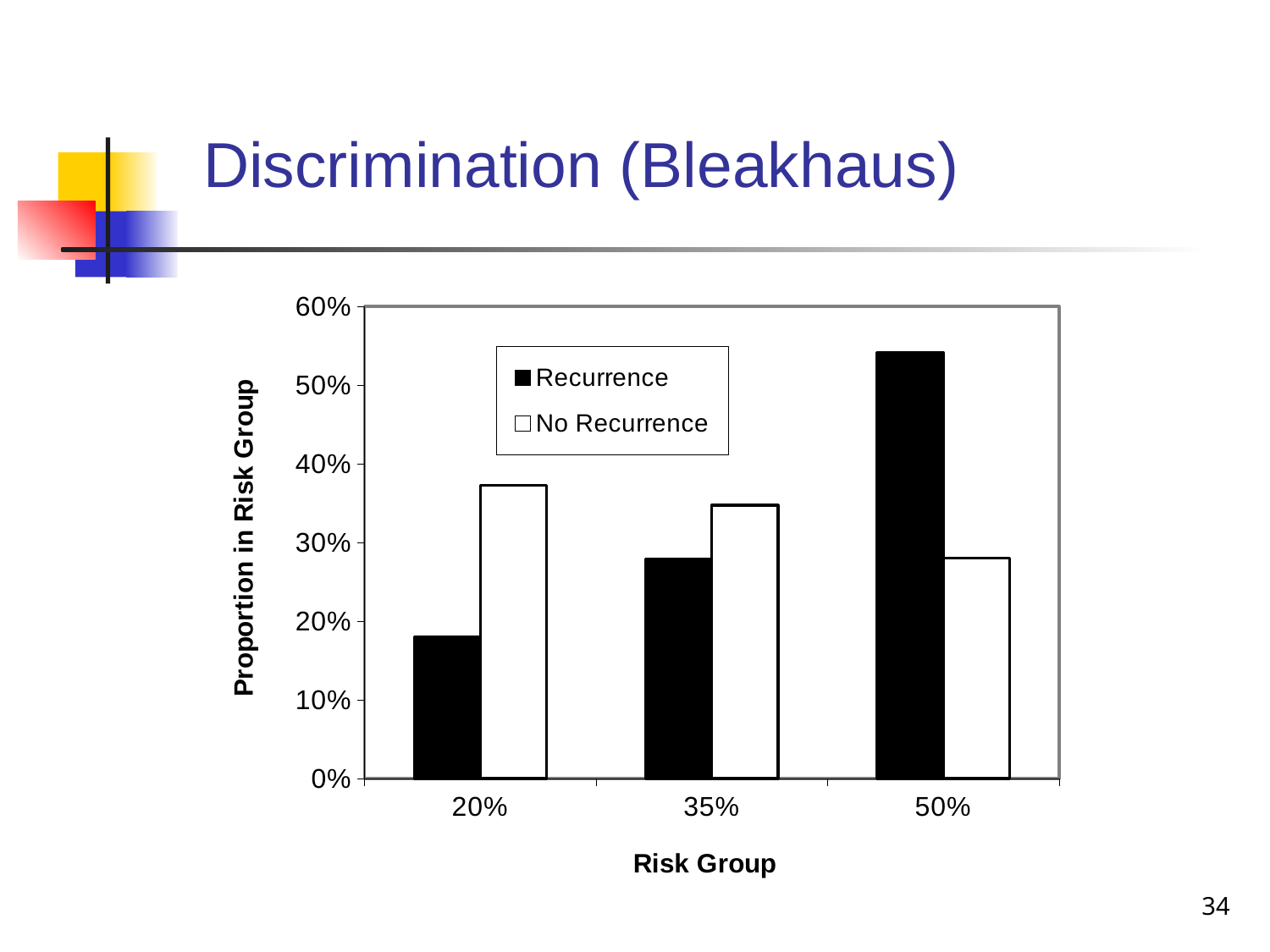
Is the No Recurrence value for the 20% risk group greater or less than 30%? greater Do the Recurrence values rise or fall as the risk group increases from 20% to 50%? rise For which risk group is the No Recurrence bar lowest? 50% What kind of chart is shown on the slide? Bar chart For which risk group is the Recurrence bar highest? 50% In the 20% risk group, which is larger: Recurrence or No Recurrence? No Recurrence In the 50% risk group, which is larger: Recurrence or No Recurrence? Recurrence Is the Recurrence value for the 50% risk group greater or less than 50%? greater What is the label of the y axis? Proportion in Risk Group For which risk group is the Recurrence bar lowest? 20% How many series does the legend list? 2 How many risk groups are shown on the x axis? 3